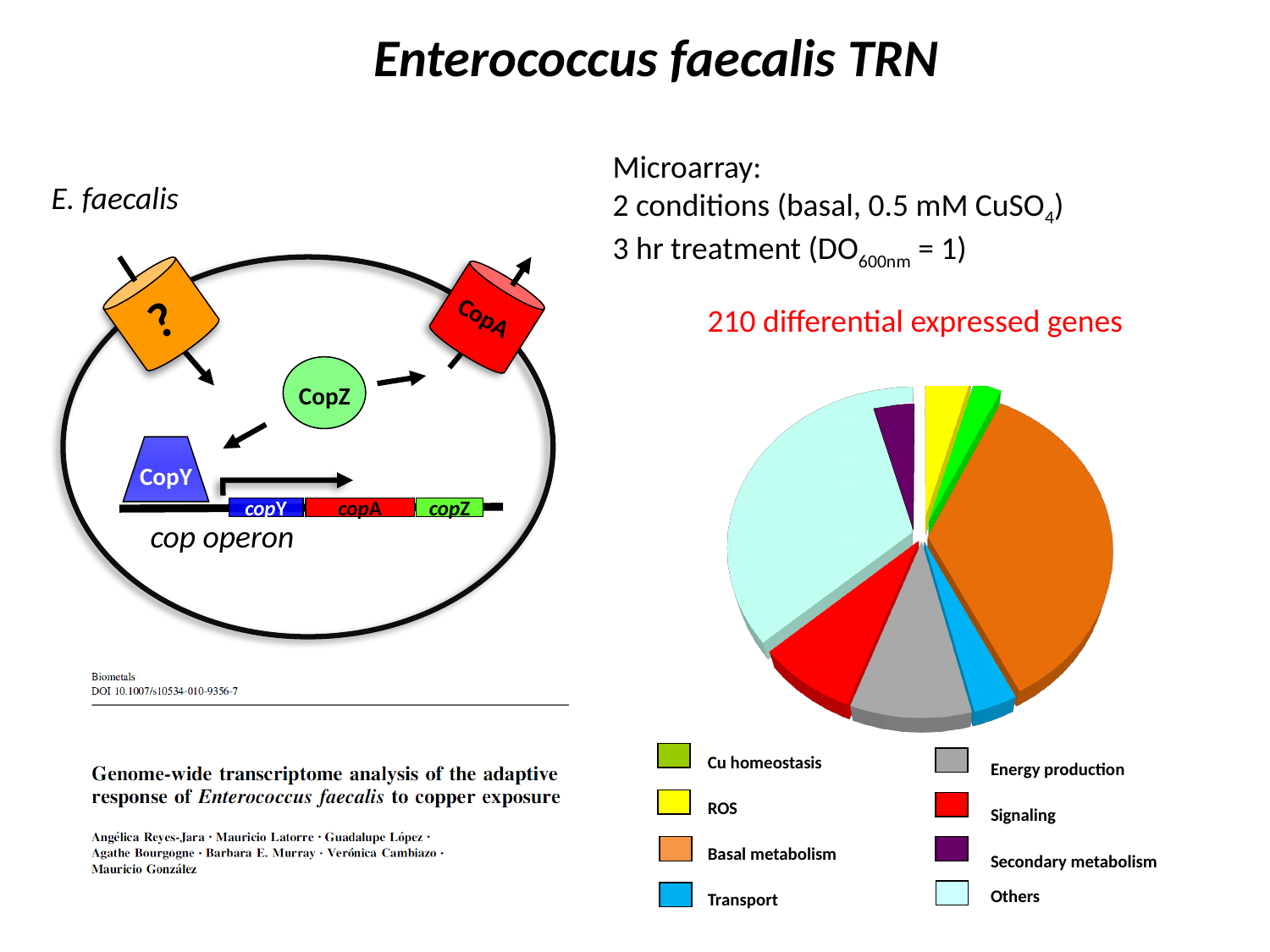
What colour represents Signaling in the pie chart? red In the pie chart, which slice is larger: Energy production or Transport? Energy production In the pie chart, which slice is larger: Others or Transport? Others According to the heading above the pie chart, how many differentially expressed genes does the chart represent? 210 How many slices does the pie chart have? 8 In the pie chart, which slice is larger: Others or Signaling? Others What kind of chart is shown on the right side of the slide? pie chart How many categories does the legend of the pie chart list? 8